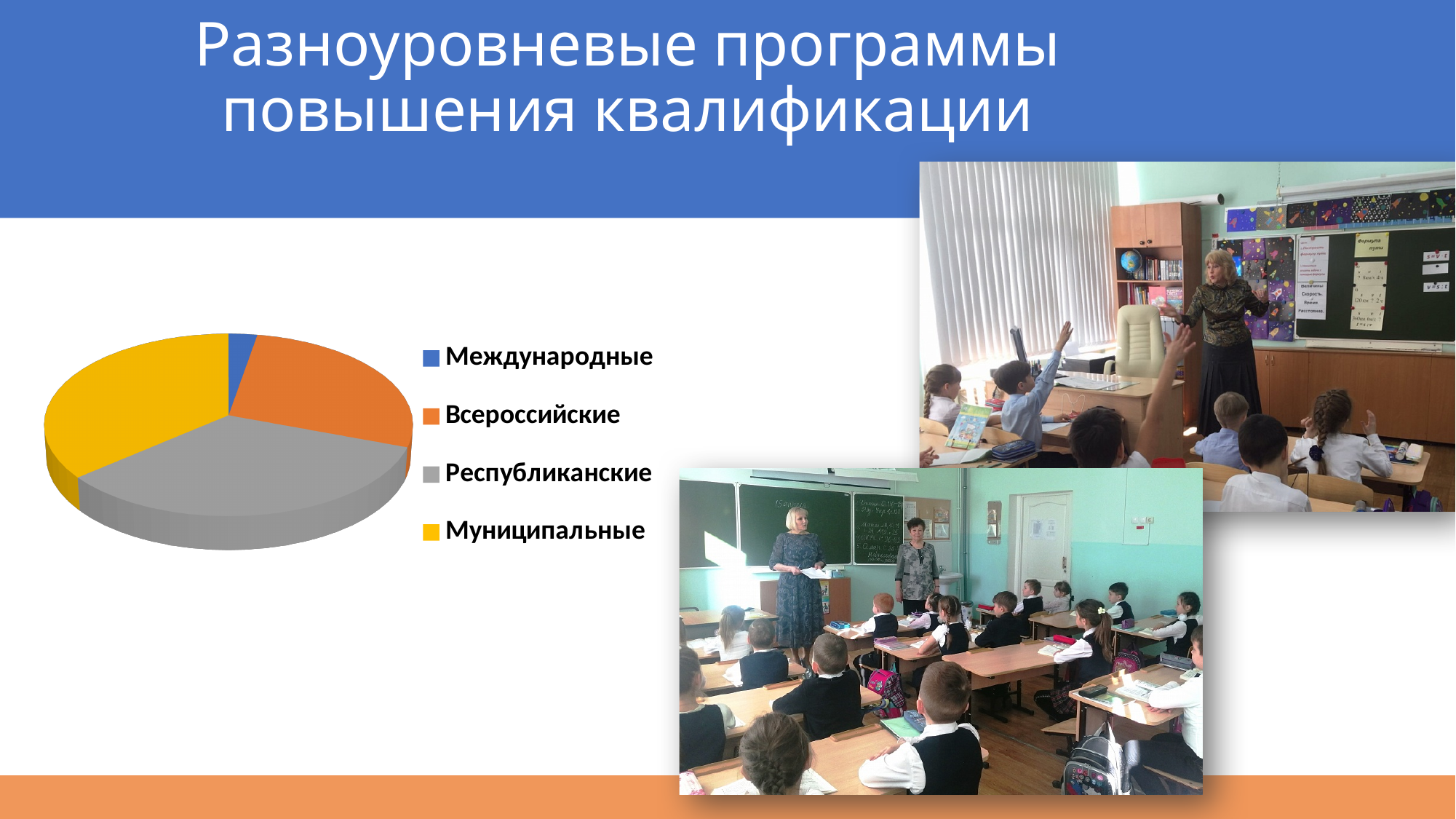
Which slice is larger in the pie chart, Всероссийские or Международные? Всероссийские Which slice is larger in the pie chart, Муниципальные or Международные? Муниципальные Which slice is larger in the pie chart, Республиканские or Международные? Республиканские How many categories does the pie chart have? 4 What colour is the Муниципальные slice in the pie chart? yellow What kind of chart is shown on the slide? pie chart Which category is shown in gray in the pie chart? Республиканские Which category has the smallest slice in the pie chart? Международные